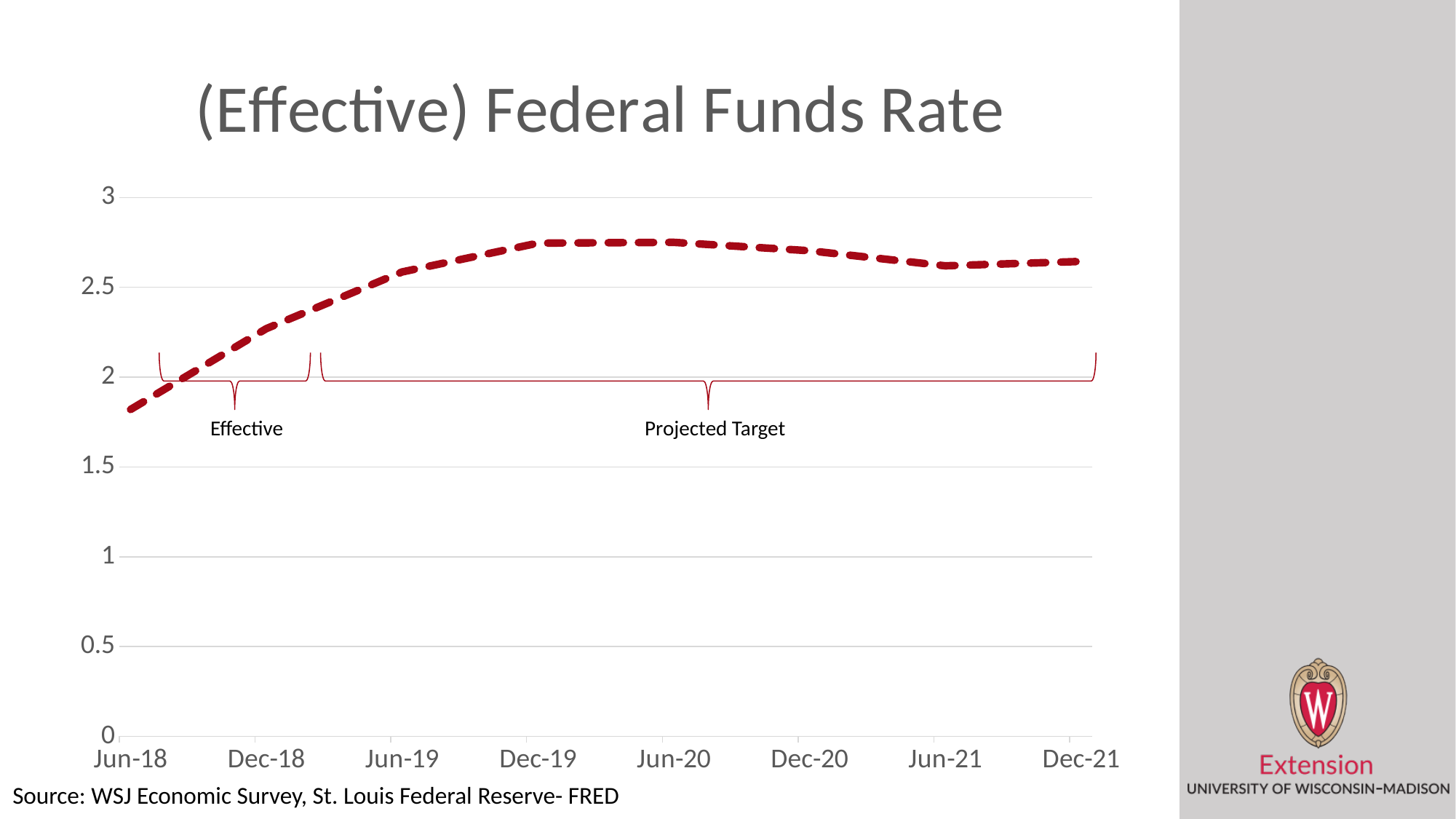
Is the value at Dec-21 greater or less than 2.5? greater What kind of chart is shown on the slide? line chart Is the value at Dec-19 greater or less than 2.5? greater Which is larger, the value at Jun-18 or the value at Dec-21? Dec-21 Is the value at Jun-18 greater or less than 2? less What is the title of the chart? (Effective) Federal Funds Rate Does the line rise or fall between Jun-18 and Dec-19? rises Does the line rise or fall between Jun-20 and Jun-21? falls At which labeled date on the x axis is the value lowest? Jun-18 How many date labels are shown on the x axis? 8